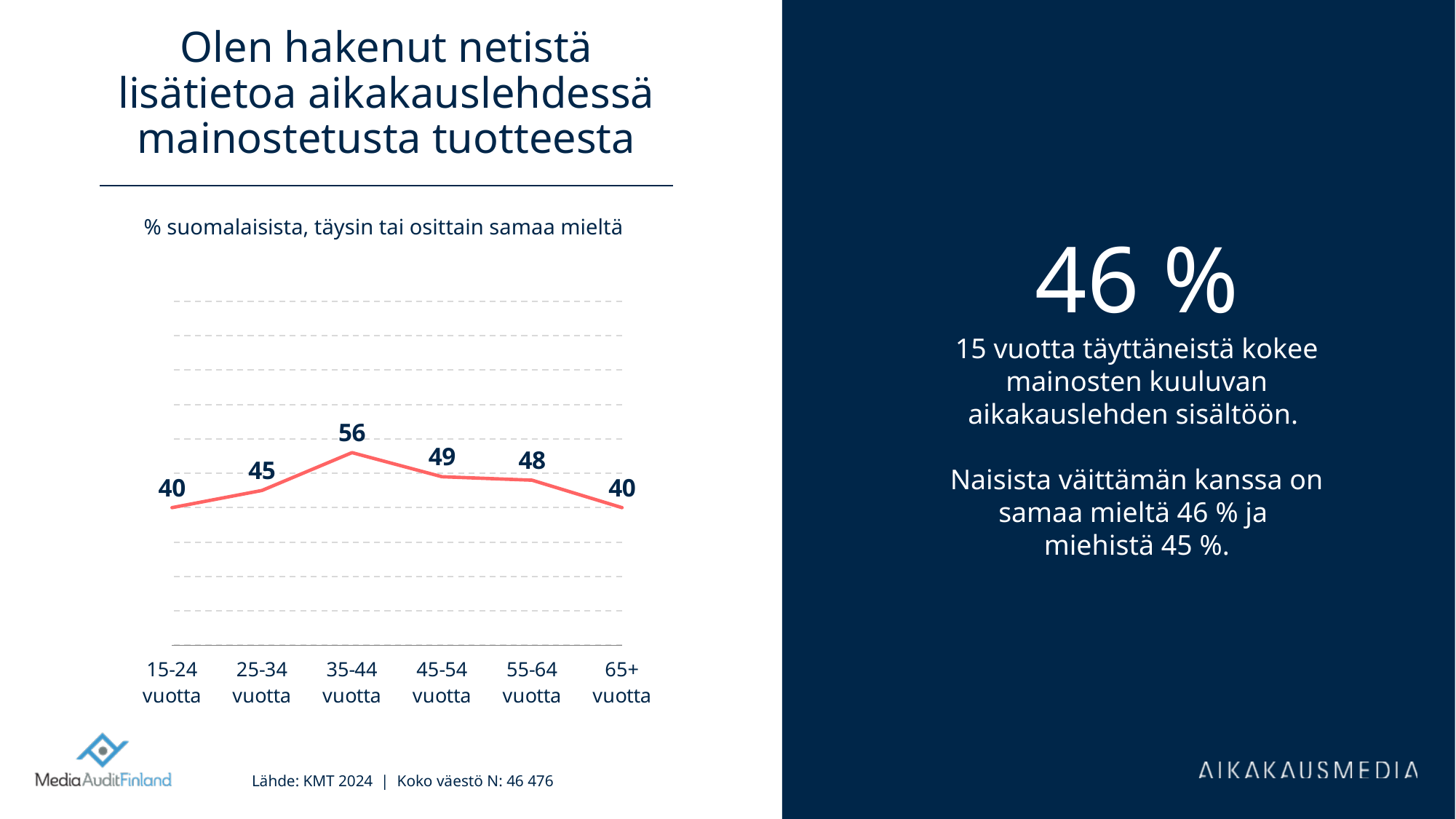
What is the difference between the values for 35-44 vuotta and 15-24 vuotta? 16 Which is larger, the value for 25-34 vuotta or the value for 45-54 vuotta? 45-54 vuotta What is the subtitle shown above the chart? % suomalaisista, täysin tai osittain samaa mieltä What kind of chart is shown on the slide? Line chart Do the values rise or fall from 35-44 vuotta to 65+ vuotta? Fall How many age groups are plotted on the chart? 6 What colour is the line in the chart? Red Which age group has the highest value? 35-44 vuotta What is the value for the 35-44 vuotta age group? 56 What is the value for the 25-34 vuotta age group? 45 What is the value for the 55-64 vuotta age group? 48 What is the difference between the values for 45-54 vuotta and 65+ vuotta? 9